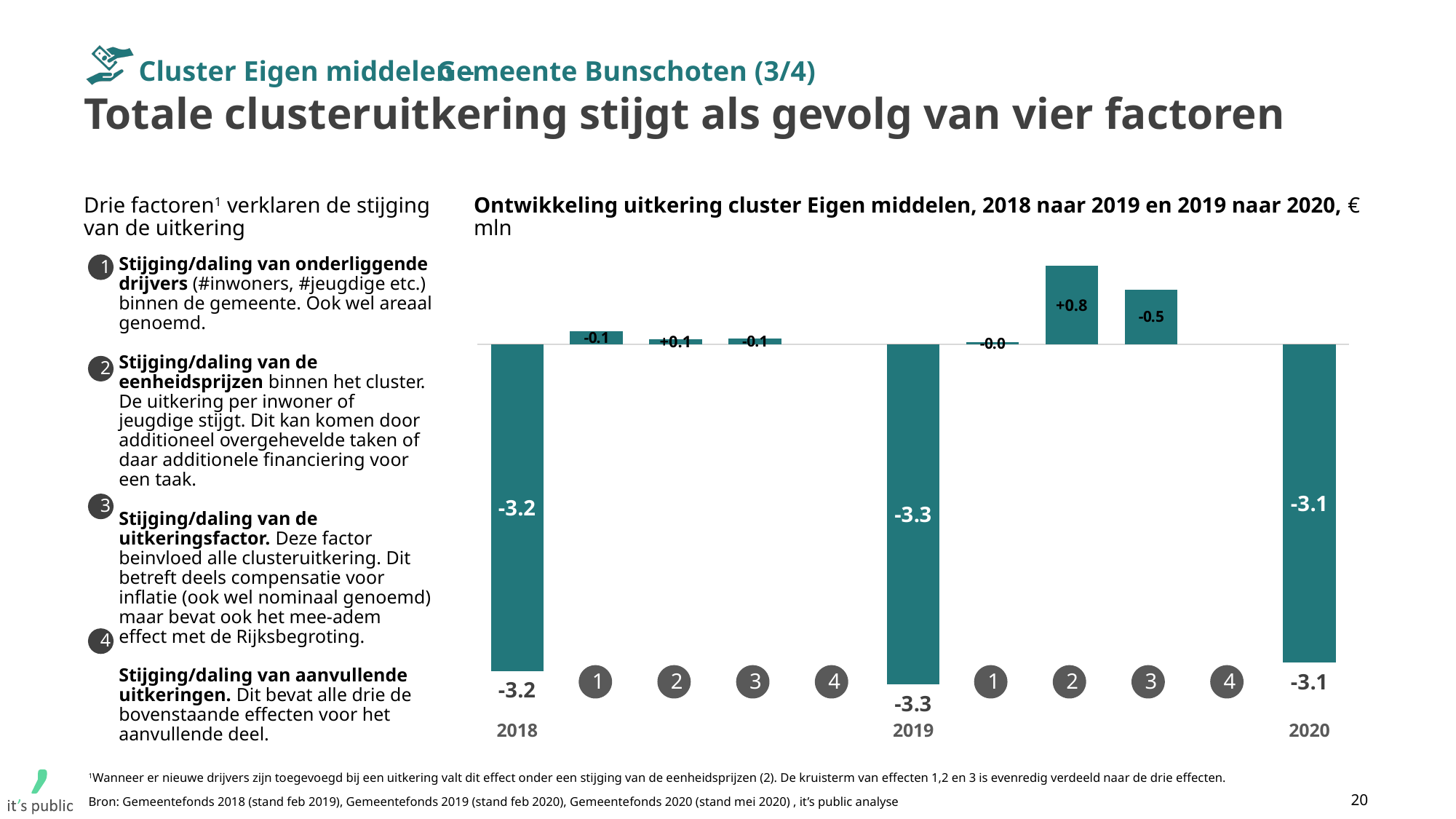
What is the value of the 2018 bar in the chart? -3.2 What is the value labelled on the bar for factor 1 between 2019 and 2020? -0.0 What is the difference between the 2020 value and the 2019 value? 0.2 What is the value labelled on the bar for factor 3 between 2019 and 2020? -0.5 What is the value of the 2019 bar in the chart? -3.3 What is the value of the 2020 bar in the chart? -3.1 Which year bar has the lowest value: 2018, 2019 or 2020? 2019 What unit is stated in the chart title? € mln What is the value labelled on the bar for factor 2 between 2018 and 2019? +0.1 What is the value labelled on the bar for factor 2 between 2019 and 2020? +0.8 What type of chart is shown on the slide? Bar chart What is the value labelled on the bar for factor 1 between 2018 and 2019? -0.1